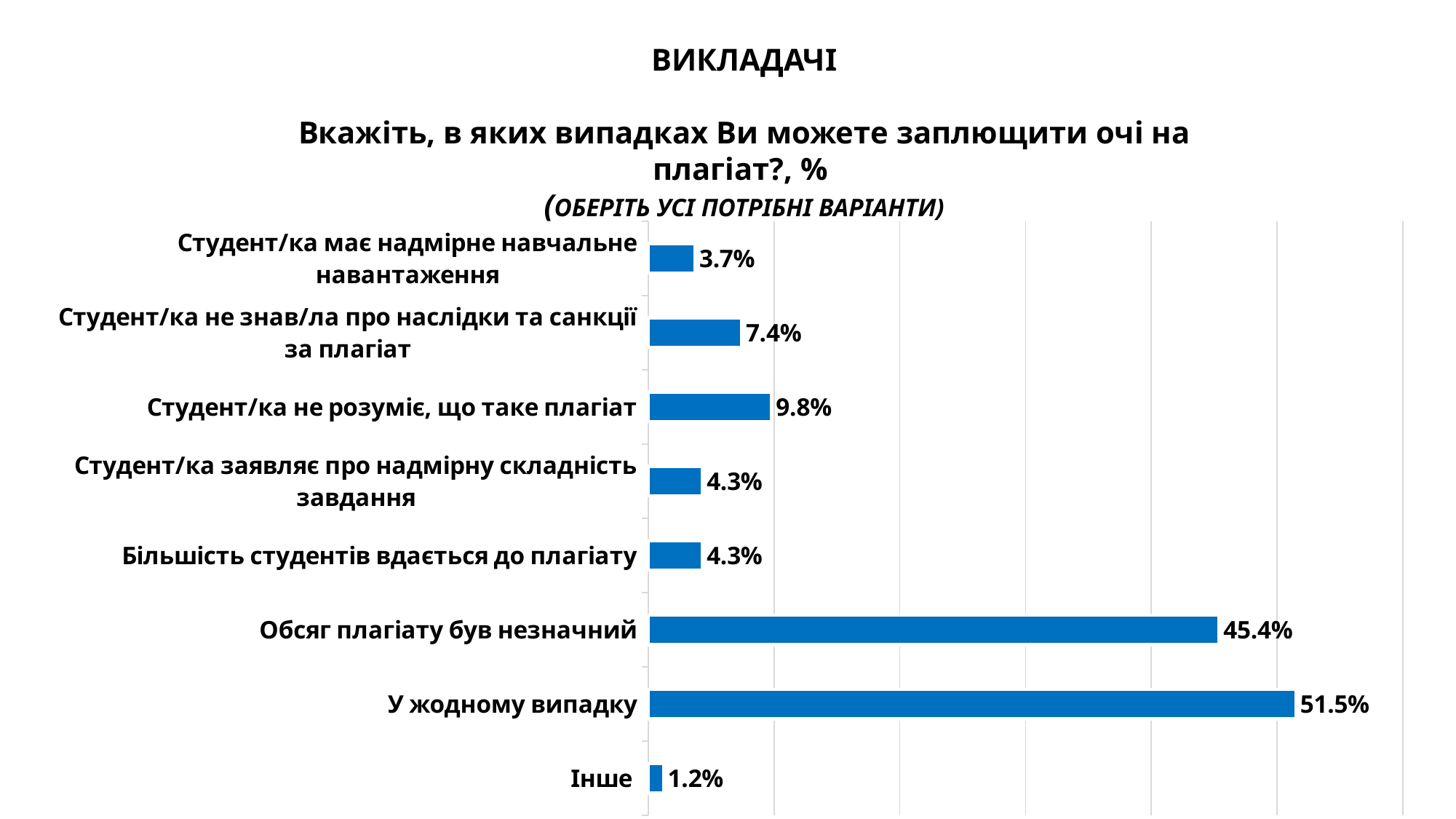
What is the difference between the values for "У жодному випадку" and "Обсяг плагіату був незначний"? 6.1 percentage points What type of chart is shown on the slide? Bar chart Which category has the highest value? У жодному випадку Which is larger: the value for "Студент/ка не розуміє, що таке плагіат" or for "Студент/ка не знав/ла про наслідки та санкції за плагіат"? Студент/ка не розуміє, що таке плагіат What is the value for "Обсяг плагіату був незначний"? 45.4% What is the value for "Інше"? 1.2% Which category has the lowest value? Інше What is the value for "У жодному випадку"? 51.5% What is the value for "Студент/ка не знав/ла про наслідки та санкції за плагіат"? 7.4% How many categories are shown in the chart? 8 What is the value for "Студент/ка не розуміє, що таке плагіат"? 9.8% What is the heading shown above the chart title? ВИКЛАДАЧІ